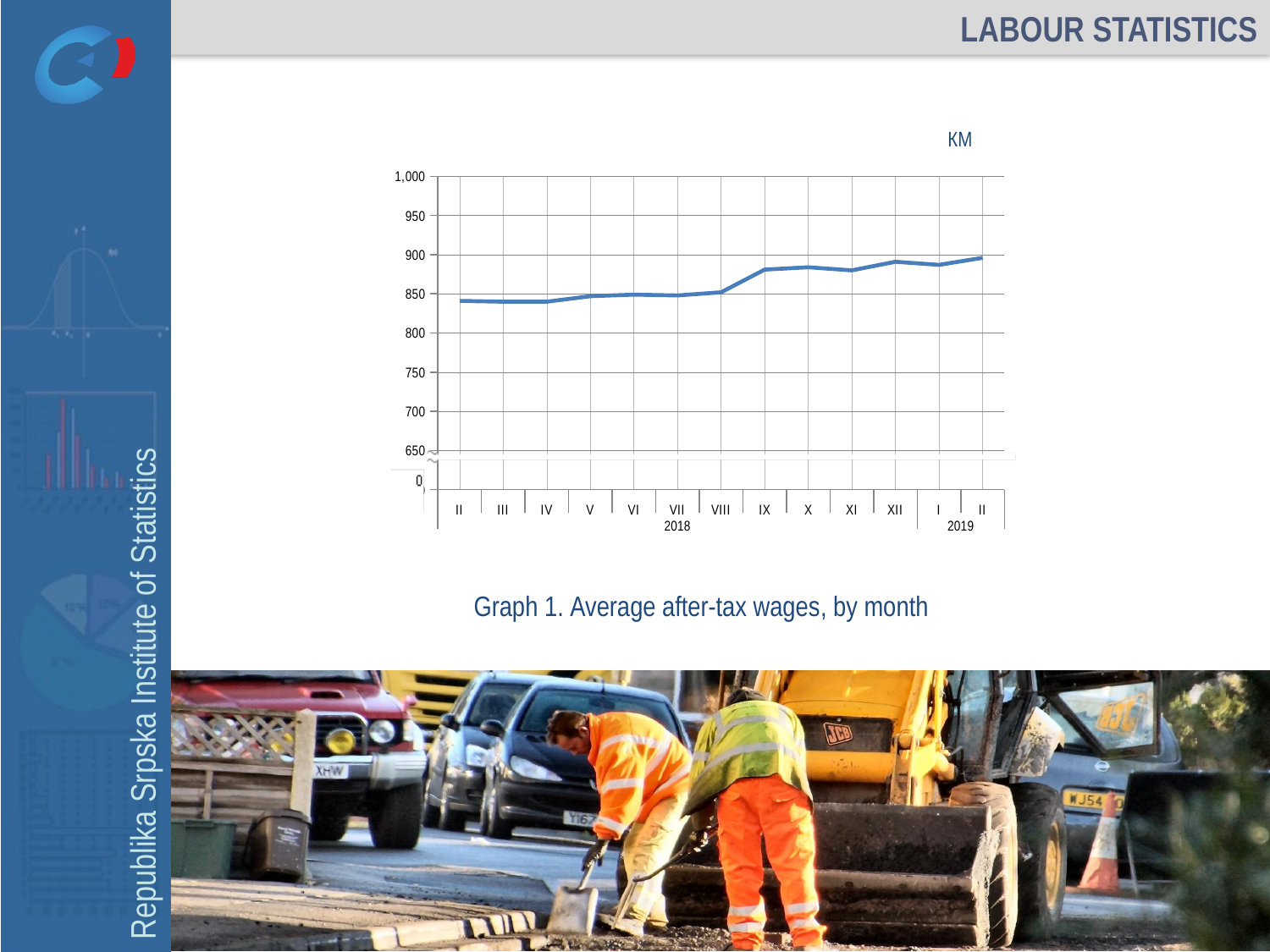
Is the value for V 2018 greater or less than 900? less What unit is shown above the chart? KM Is the value for II 2018 greater or less than 850? less What is the caption of the chart? Graph 1. Average after-tax wages, by month What kind of chart is shown on the slide? line chart Do the average after-tax wages generally rise or fall from II 2018 to II 2019? rise Which is larger, the value for II 2018 or the value for II 2019? II 2019 How many monthly points are plotted on the line chart? 13 Is the value for XII 2018 greater or less than 850? greater Which is larger, the value for VIII 2018 or the value for IX 2018? IX 2018